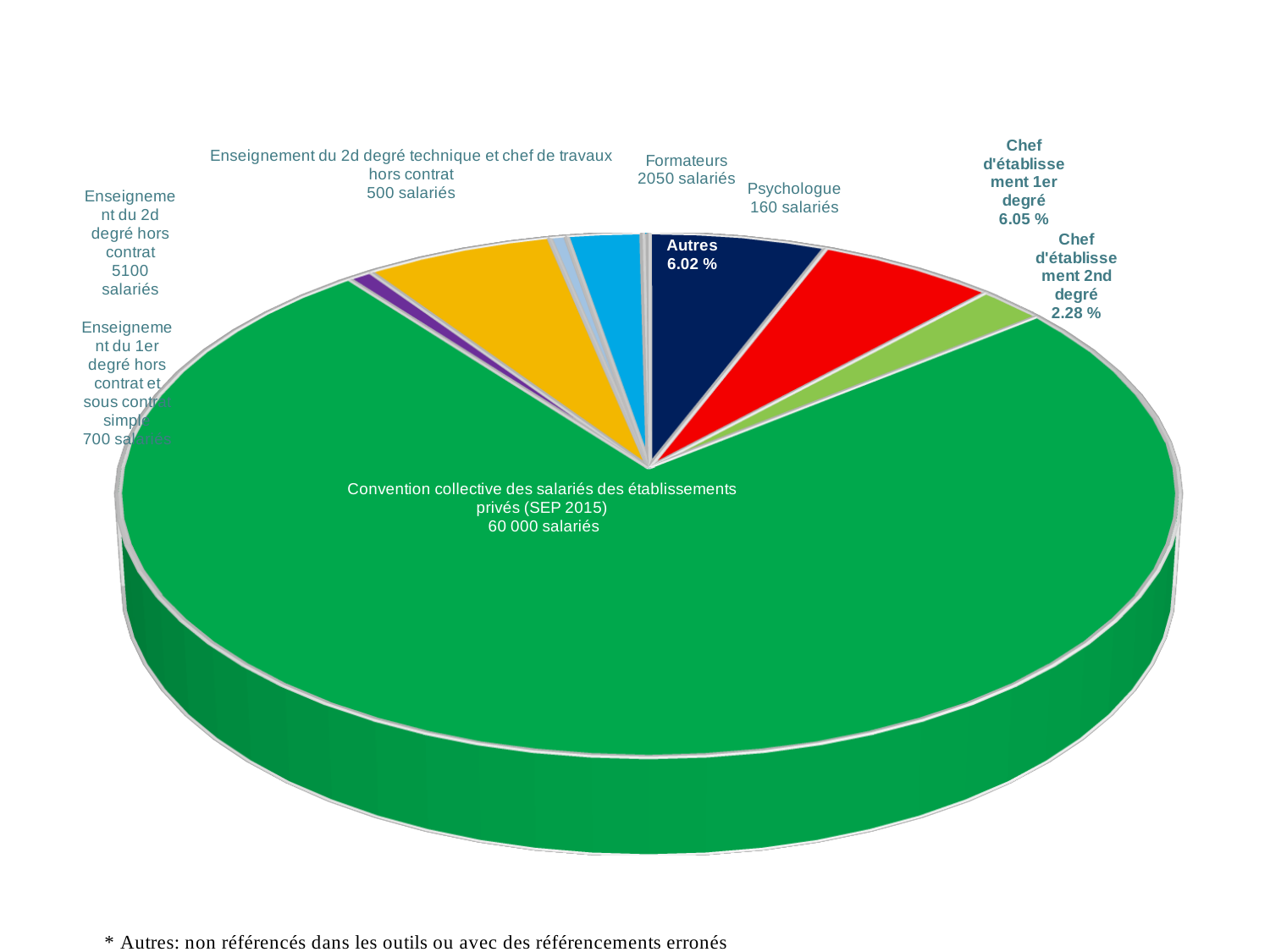
According to the footnote, what does 'Autres' refer to? non référencés dans les outils ou avec des référencements erronés What is the difference in salariés between 'Enseignement du 2d degré hors contrat' (5100) and 'Enseignement du 2d degré technique et chef de travaux hors contrat' (500)? 4600 salariés What type of chart is shown on the slide? pie chart How many salariés are shown for 'Psychologue'? 160 salariés What percentage is shown for 'Chef d'établissement 2nd degré'? 2.28 % What percentage is shown for the 'Autres' slice? 6.02 % What percentage is shown for 'Chef d'établissement 1er degré'? 6.05 % How many salariés are shown for the slice 'Convention collective des salariés des établissements privés (SEP 2015)'? 60 000 salariés How many salariés are shown for 'Formateurs'? 2050 salariés Which has more salariés: 'Formateurs' or 'Enseignement du 2d degré hors contrat'? Enseignement du 2d degré hors contrat How many salariés are shown for 'Enseignement du 2d degré hors contrat'? 5100 salariés Which category has the largest slice of the pie? Convention collective des salariés des établissements privés (SEP 2015)